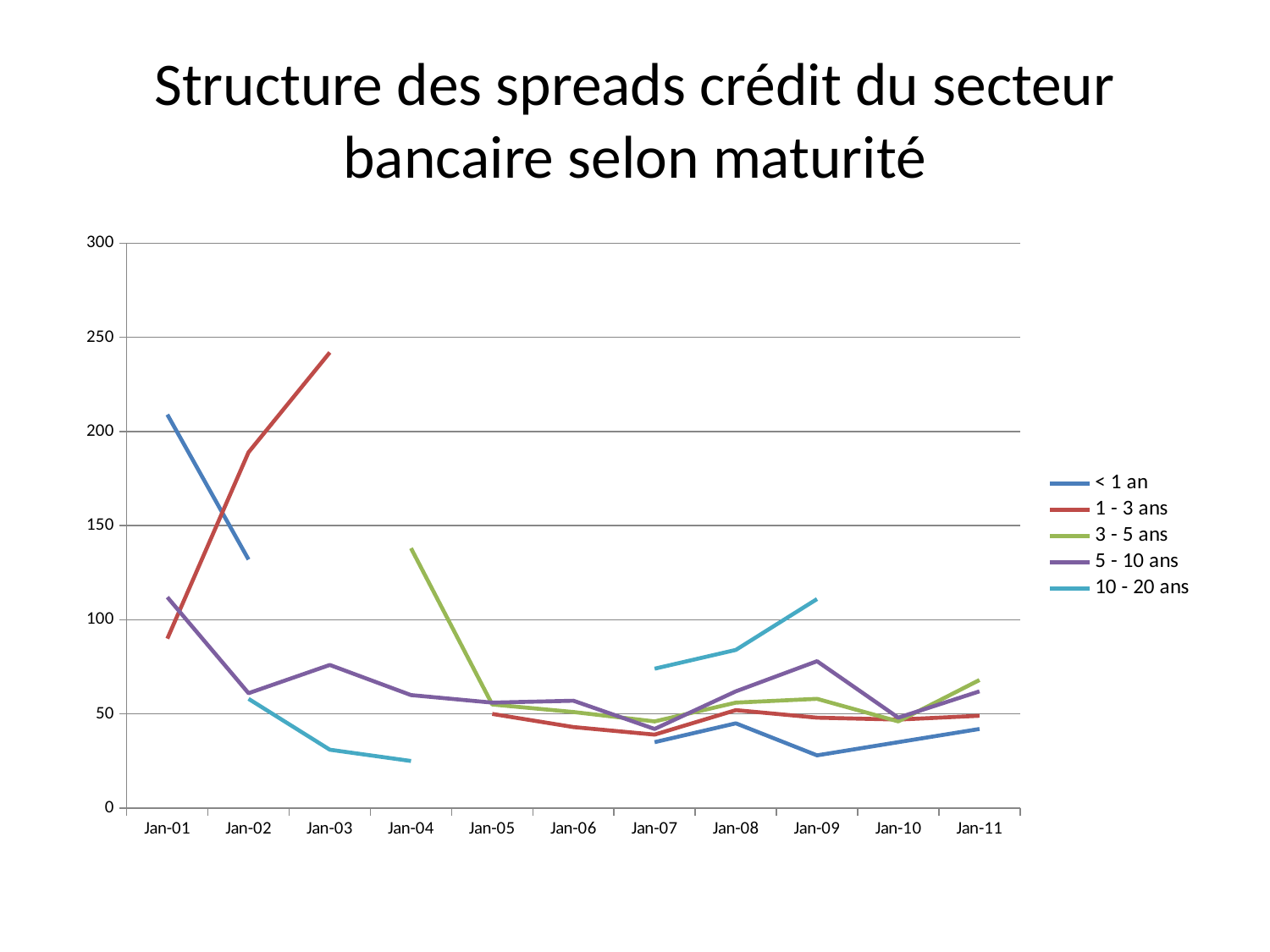
At Jan-09, which series has the larger value: '10 - 20 ans' or '< 1 an'? 10 - 20 ans Which series reaches the highest value anywhere on the chart? 1 - 3 ans What kind of chart is shown on the slide? line chart Is the value for the '1 - 3 ans' series at Jan-03 greater or less than 200? greater How many series does the legend list? 5 Does the '1 - 3 ans' series rise or fall from Jan-01 to Jan-03? rise Does the '10 - 20 ans' series rise or fall from Jan-07 to Jan-09? rise At Jan-01, which series has the larger value: '< 1 an' or '1 - 3 ans'? < 1 an How many dates are labelled along the x axis? 11 Is the value for the '10 - 20 ans' series at Jan-04 greater or less than 50? less At which date does the '< 1 an' series reach its lowest value? Jan-09 Is the value for the '< 1 an' series at Jan-01 greater or less than 150? greater